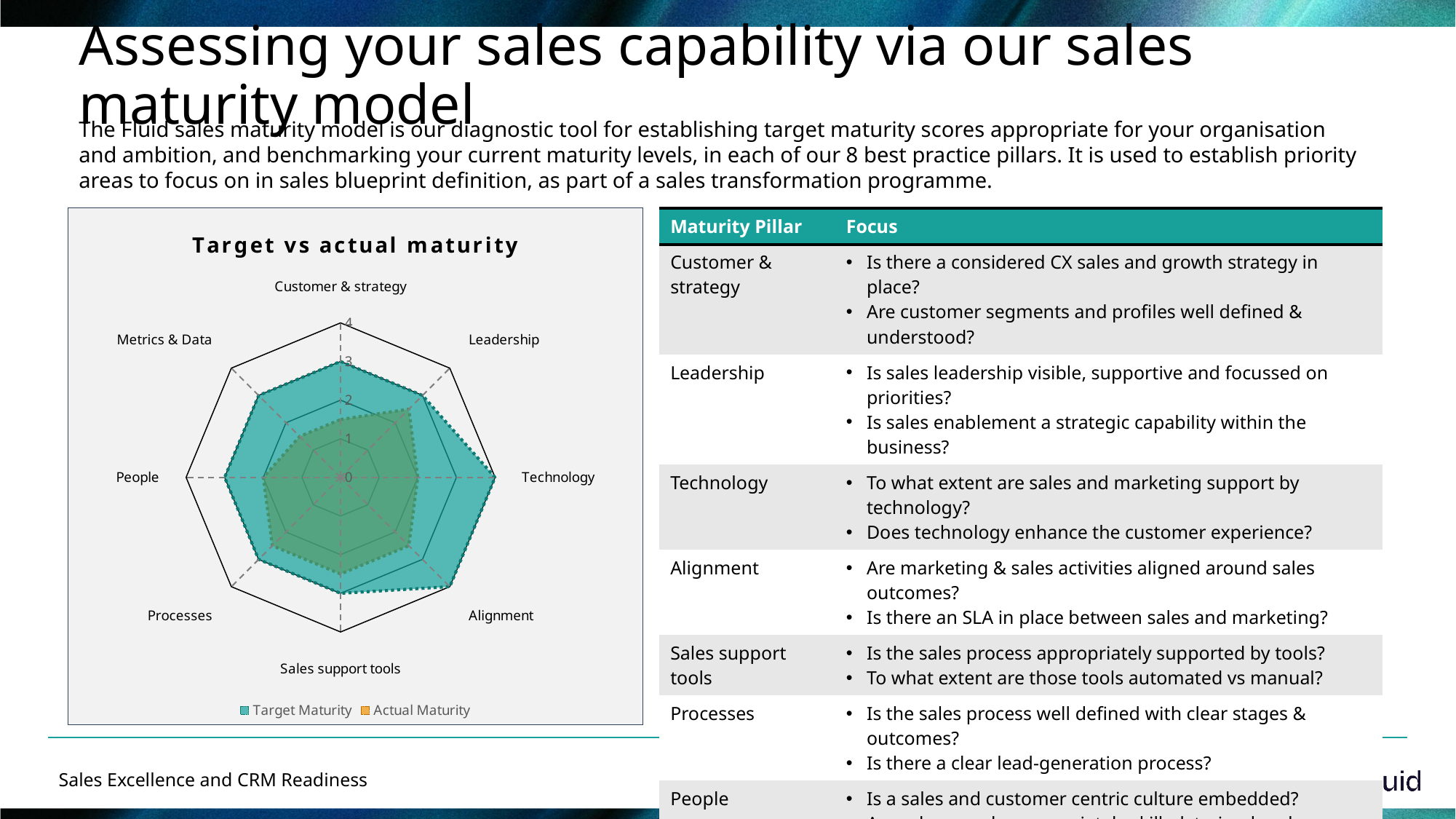
Is the Actual Maturity value for Leadership greater or less than 3? less What is the Target Maturity value for Technology? 4 What is the title of the chart? Target vs actual maturity Which category has the highest Target Maturity value? Technology and Alignment (tied at 4) How many series does the chart legend list? 2 Is the Target Maturity value for People greater or less than 2? greater What is the maximum value shown on the radar chart's axis scale? 4 Is the Actual Maturity value for Technology greater or less than 3? less How many maturity pillars (categories) are plotted on the radar chart? 8 For Technology, which is larger: Target Maturity or Actual Maturity? Target Maturity What kind of chart is shown on the slide? Radar chart What are the two series named in the chart legend? Target Maturity and Actual Maturity